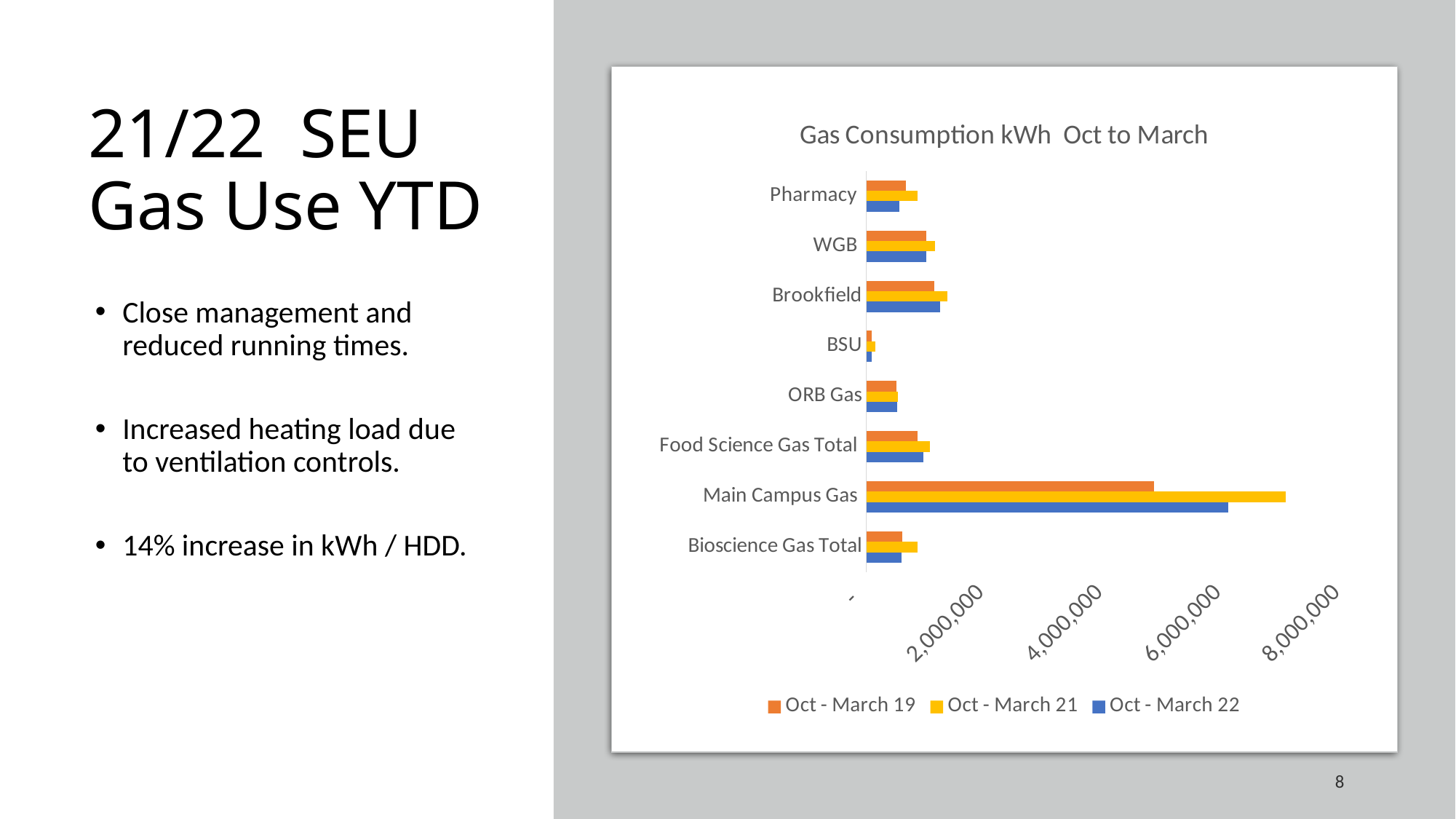
Which category has the lowest gas consumption in the chart? BSU What is the title of the chart? Gas Consumption kWh Oct to March Is the Oct - March 22 value for Brookfield greater or less than 2,000,000? less Which category has the highest gas consumption in the chart? Main Campus Gas Which series is shown in blue in the chart legend? Oct - March 22 Is the Oct - March 21 value for Main Campus Gas greater or less than 6,000,000? greater What type of chart is shown on the slide? Bar chart How many categories are shown on the chart's vertical axis? 8 Is the Oct - March 19 value for Main Campus Gas greater or less than 6,000,000? less For Main Campus Gas, which series has the larger value: Oct - March 19 or Oct - March 21? Oct - March 21 How many series does the chart legend list? 3